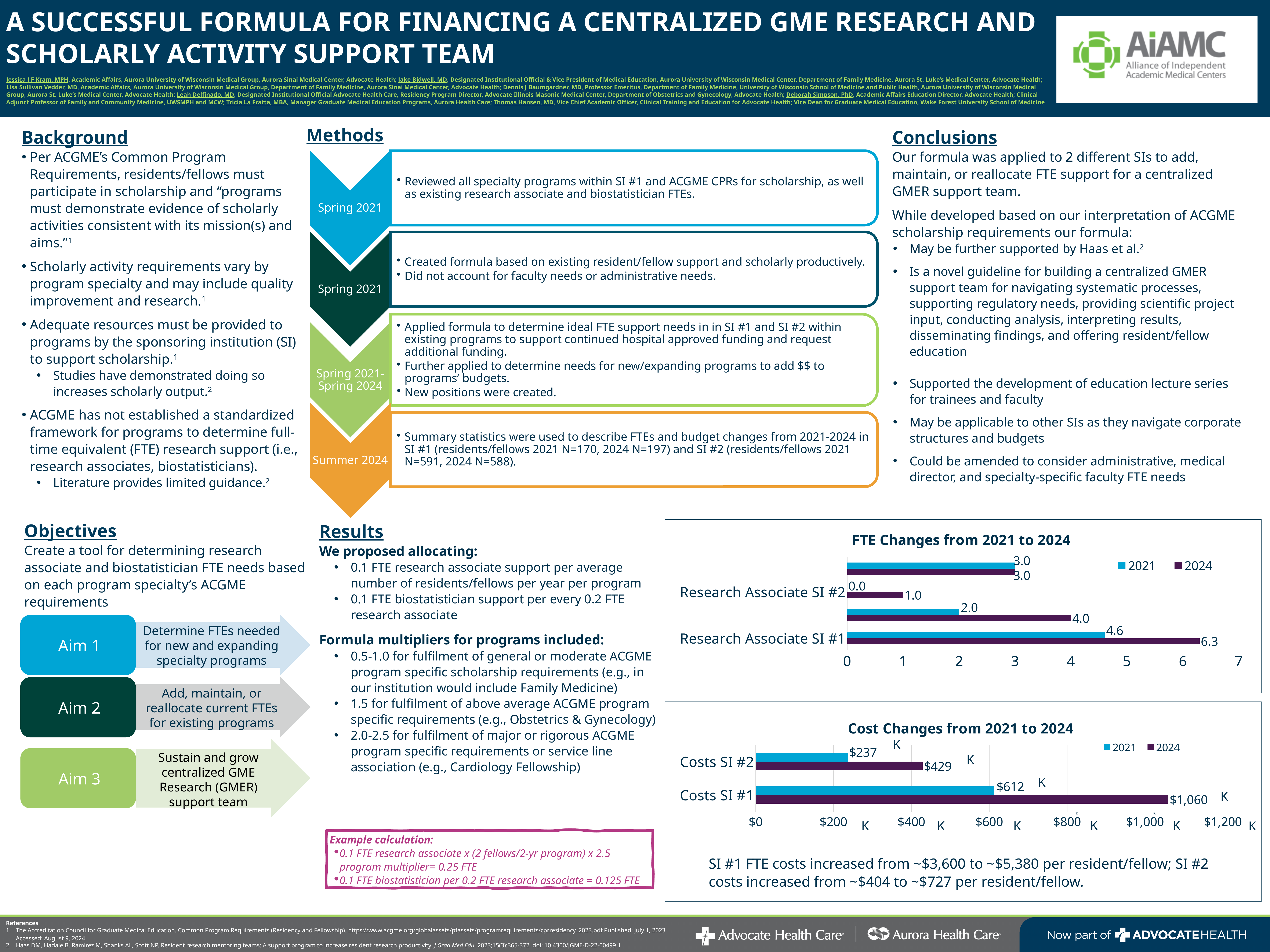
How many series does the legend of the 'FTE Changes from 2021 to 2024' chart list? 2 In the 'FTE Changes from 2021 to 2024' chart, what is the 2021 value for Research Associate SI #1? 4.6 In the 'Cost Changes from 2021 to 2024' chart, what is the difference between the 2024 and 2021 values for Costs SI #1? $448K In the 'FTE Changes from 2021 to 2024' chart, what is the 2024 value for Research Associate SI #1? 6.3 In the 'FTE Changes from 2021 to 2024' chart, what is the 2021 value for Research Associate SI #2? 0.0 What kind of chart is the 'FTE Changes from 2021 to 2024' chart? Bar chart In the 'Cost Changes from 2021 to 2024' chart, what is the 2024 value for Costs SI #2? $429K In the 'Cost Changes from 2021 to 2024' chart, what is the 2021 value for Costs SI #1? $612K What are the legend entries in the 'Cost Changes from 2021 to 2024' chart? 2021 and 2024 In the 'Cost Changes from 2021 to 2024' chart, which category has the higher 2024 value? Costs SI #1 In the 'FTE Changes from 2021 to 2024' chart, what is the 2024 value for Research Associate SI #2? 1.0 In the 'FTE Changes from 2021 to 2024' chart, by how much did the Research Associate SI #1 value increase from 2021 to 2024? 1.7